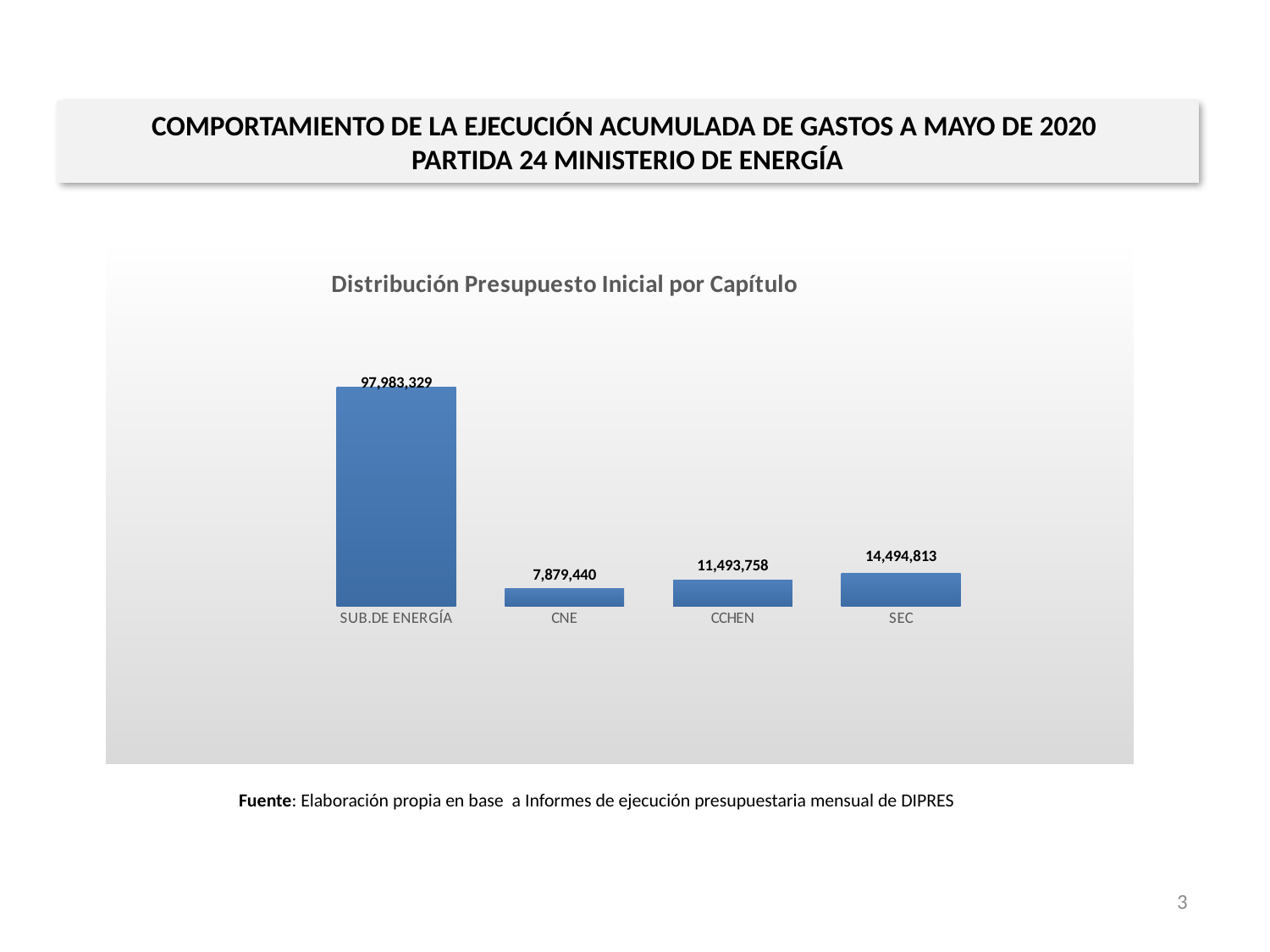
Which is larger, the value for SEC or the value for CCHEN? SEC What kind of chart is shown on the slide? Bar chart Which category has the highest value in the chart? SUB.DE ENERGÍA What is the difference between the values for CCHEN and CNE? 3,614,318 What is the title of the chart? Distribución Presupuesto Inicial por Capítulo What is the difference between the values for SEC and CCHEN? 3,001,055 What is the value for CCHEN in the chart? 11,493,758 What is the value for CNE in the chart? 7,879,440 How many categories are shown in the chart? 4 What is the value for SEC in the chart? 14,494,813 What is the value for SUB.DE ENERGÍA in the chart? 97,983,329 Which category has the lowest value in the chart? CNE